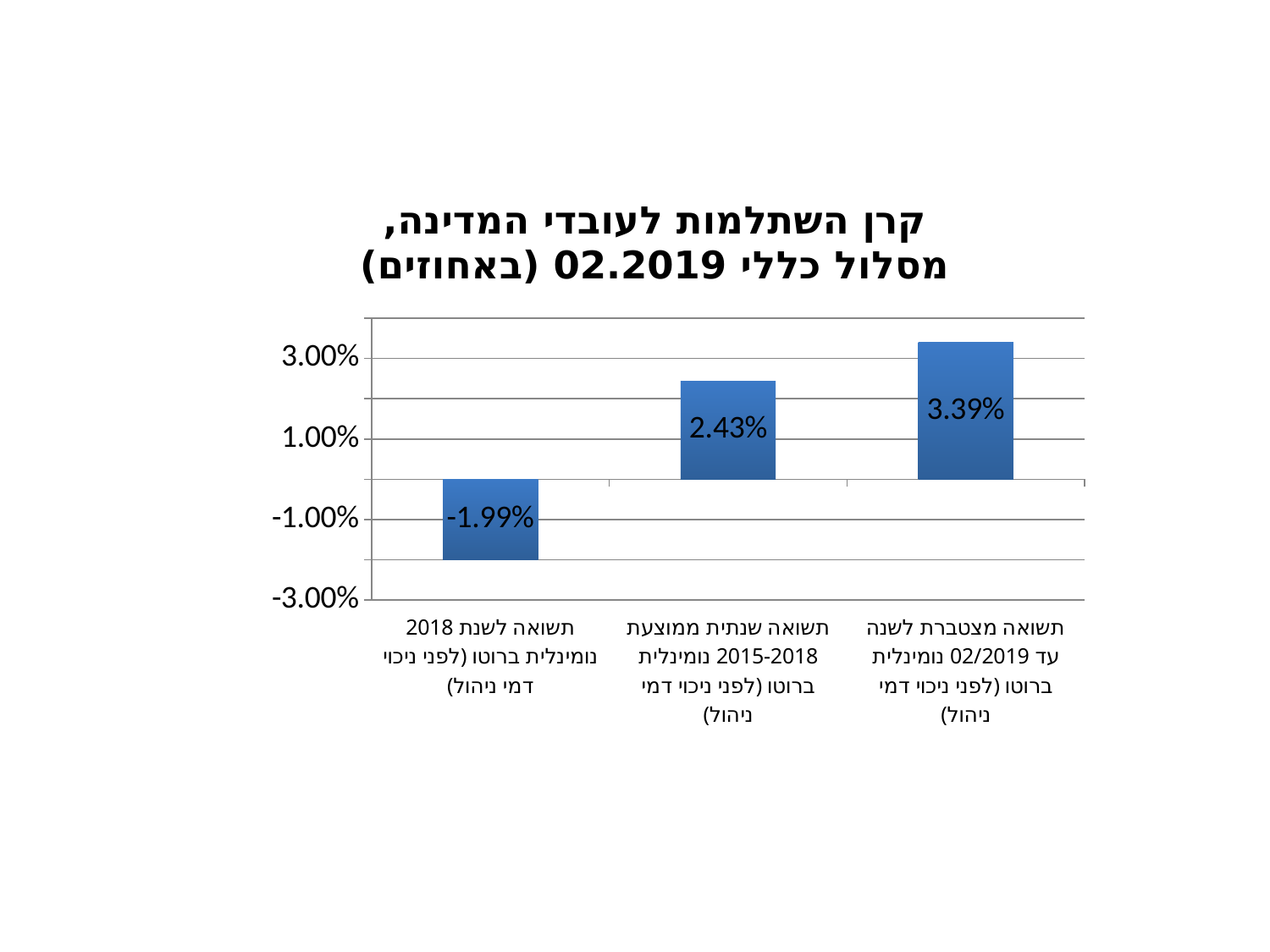
What is the value for the 2018 return (תשואה לשנת 2018 נומינלית ברוטו)? -1.99% Which category has the lowest value? תשואה לשנת 2018 נומינלית ברוטו (לפני ניכוי דמי ניהול) What is the difference between the cumulative return to 02/2019 (3.39%) and the average annual return 2015-2018 (2.43%)? 0.96% How many of the bars have a negative value? 1 How many categories are shown in the chart? 3 Which is larger: the average annual return 2015-2018 or the 2018 return? תשואה שנתית ממוצעת 2015-2018 נומינלית ברוטו (לפני ניכוי דמי ניהול) What is the title of the chart? קרן השתלמות לעובדי המדינה, מסלול כללי 02.2019 (באחוזים) Is the value for the cumulative return to 02/2019 greater or less than 3.00%? greater What is the value for the cumulative return for the year to 02/2019 (תשואה מצטברת לשנה עד 02/2019)? 3.39% Which category has the highest value? תשואה מצטברת לשנה עד 02/2019 נומינלית ברוטו (לפני ניכוי דמי ניהול) What is the value for the average annual return 2015-2018 (תשואה שנתית ממוצעת 2015-2018)? 2.43% What kind of chart is shown on the slide? bar chart